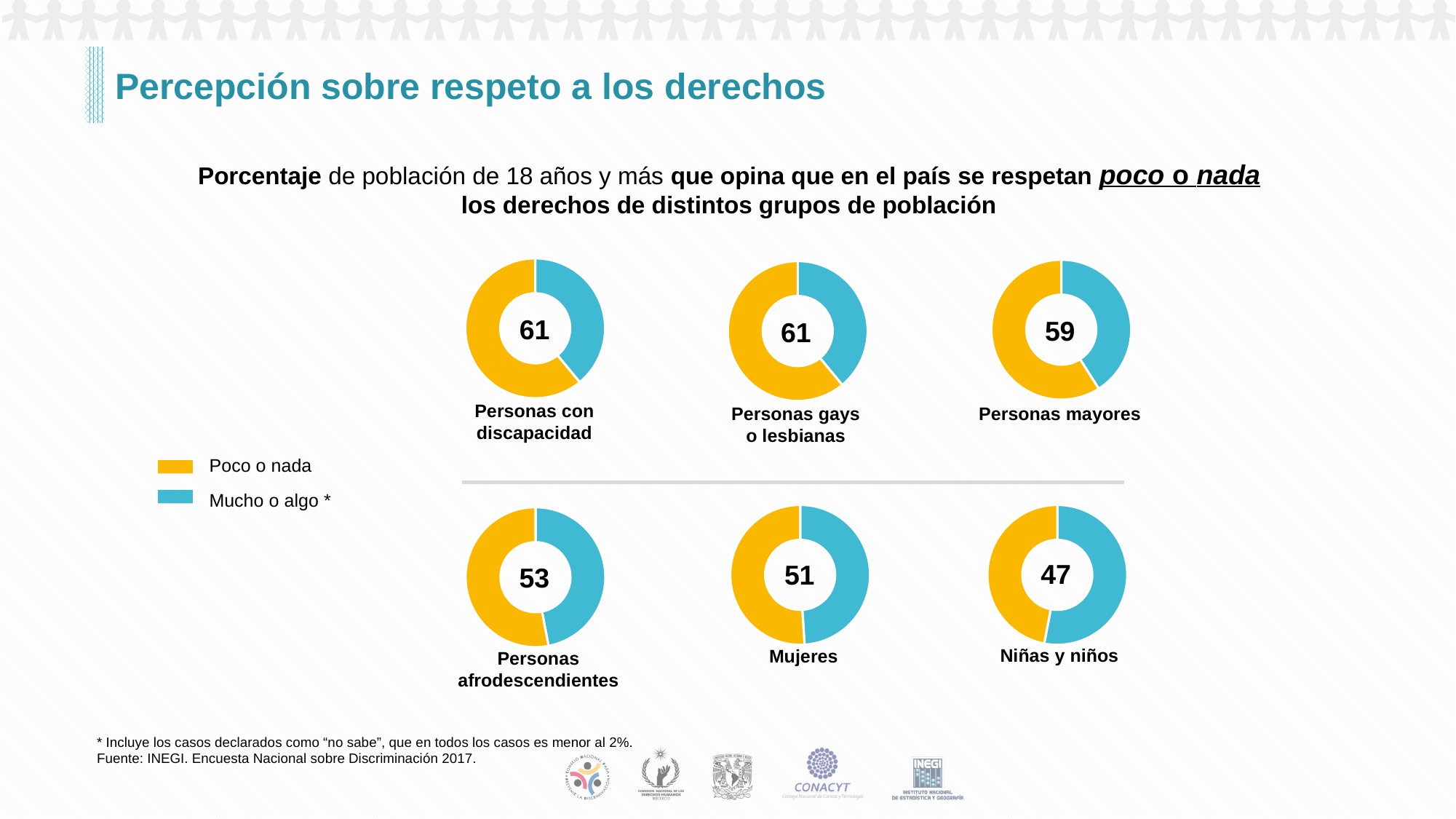
How many entries does the legend on the slide list? 2 In the 'Personas afrodescendientes' donut chart, what value is printed in the centre? 53 Across the donut charts on the slide, which has the larger printed value: 'Personas mayores' or 'Mujeres'? Personas mayores According to the legend on the slide, which category is shown in yellow? Poco o nada How many donut charts are shown on the slide? 6 In the 'Niñas y niños' donut chart, what value is printed in the centre? 47 Across the donut charts on the slide, what is the difference between the printed values for 'Personas afrodescendientes' and 'Mujeres'? 2 In the 'Personas con discapacidad' donut chart, what value is printed in the centre? 61 In the 'Personas mayores' donut chart, what value is printed in the centre? 59 Across the six donut charts on the slide, which population group has the lowest printed value? Niñas y niños In the 'Mujeres' donut chart, what value is printed in the centre? 51 Across the donut charts on the slide, what is the difference between the printed value for 'Personas con discapacidad' and the printed value for 'Niñas y niños'? 14